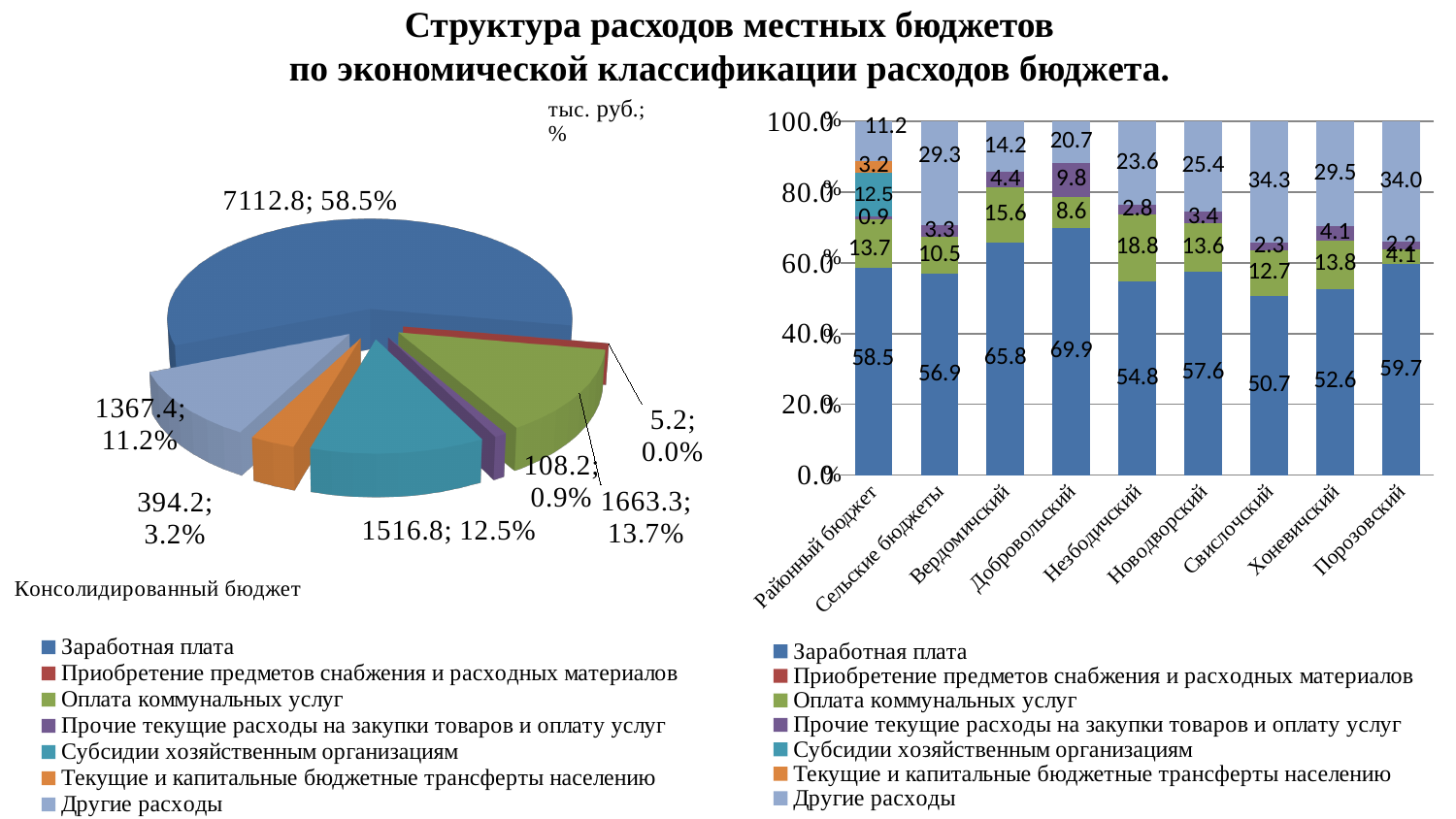
What kind of chart is the chart on the left of the slide? pie chart How many budget categories are shown on the x axis of the stacked bar chart on the right? 9 In the stacked bar chart on the right, which budget has the highest value for Заработная плата? Добровольский In the pie chart on the left, what is the value (тыс. руб.) for Субсидии хозяйственным организациям? 1516.8 In the stacked bar chart on the right, what is the difference between the Заработная плата values for Добровольский and Свислочский? 19.2 In the stacked bar chart on the right, what is the value of Другие расходы for Свислочский? 34.3 In the stacked bar chart on the right, which has the larger value for Другие расходы: Сельские бюджеты or Вердомичский? Сельские бюджеты How many series does the legend of the stacked bar chart on the right list? 7 In the stacked bar chart on the right, which budget has the lowest value for Заработная плата? Свислочский How many slices does the pie chart on the left have? 7 In the pie chart on the left (Консолидированный бюджет), what percentage share does Заработная плата have? 58.5% In the stacked bar chart on the right, what is the value of Заработная плата for Добровольский? 69.9